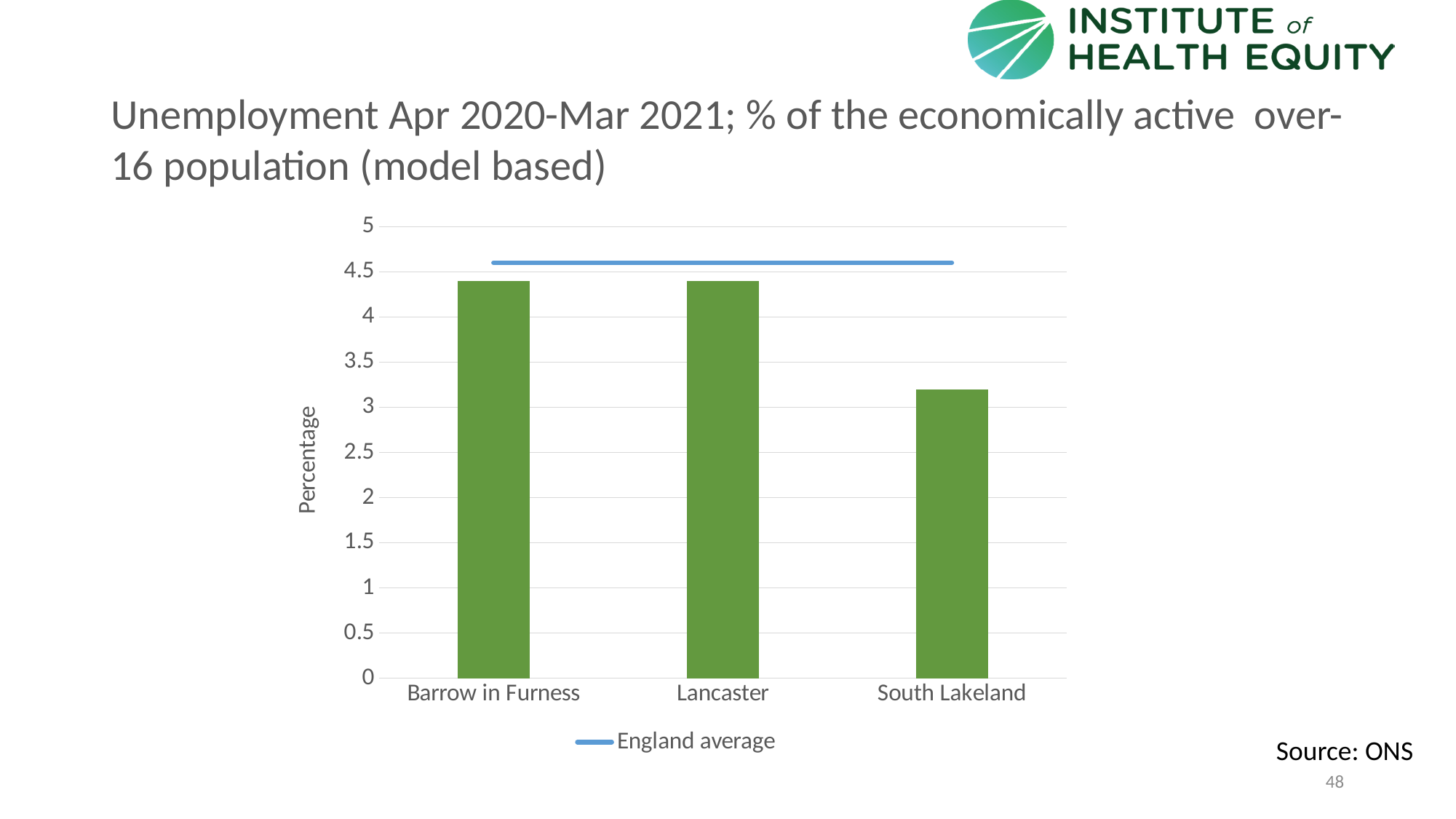
Is the value for South Lakeland greater or less than 3? greater Which area has the lowest unemployment rate in the chart? South Lakeland What does the blue horizontal line in the chart represent, according to the legend? England average How many entries does the chart's legend list? 1 Is the value for Barrow in Furness greater or less than 4? greater Is the value for Lancaster greater or less than 4.5? less What is the label on the chart's vertical axis? Percentage Which is larger, the value for Lancaster or the value for South Lakeland? Lancaster What kind of chart is shown on the slide? bar chart How many local areas are shown on the x axis of the chart? 3